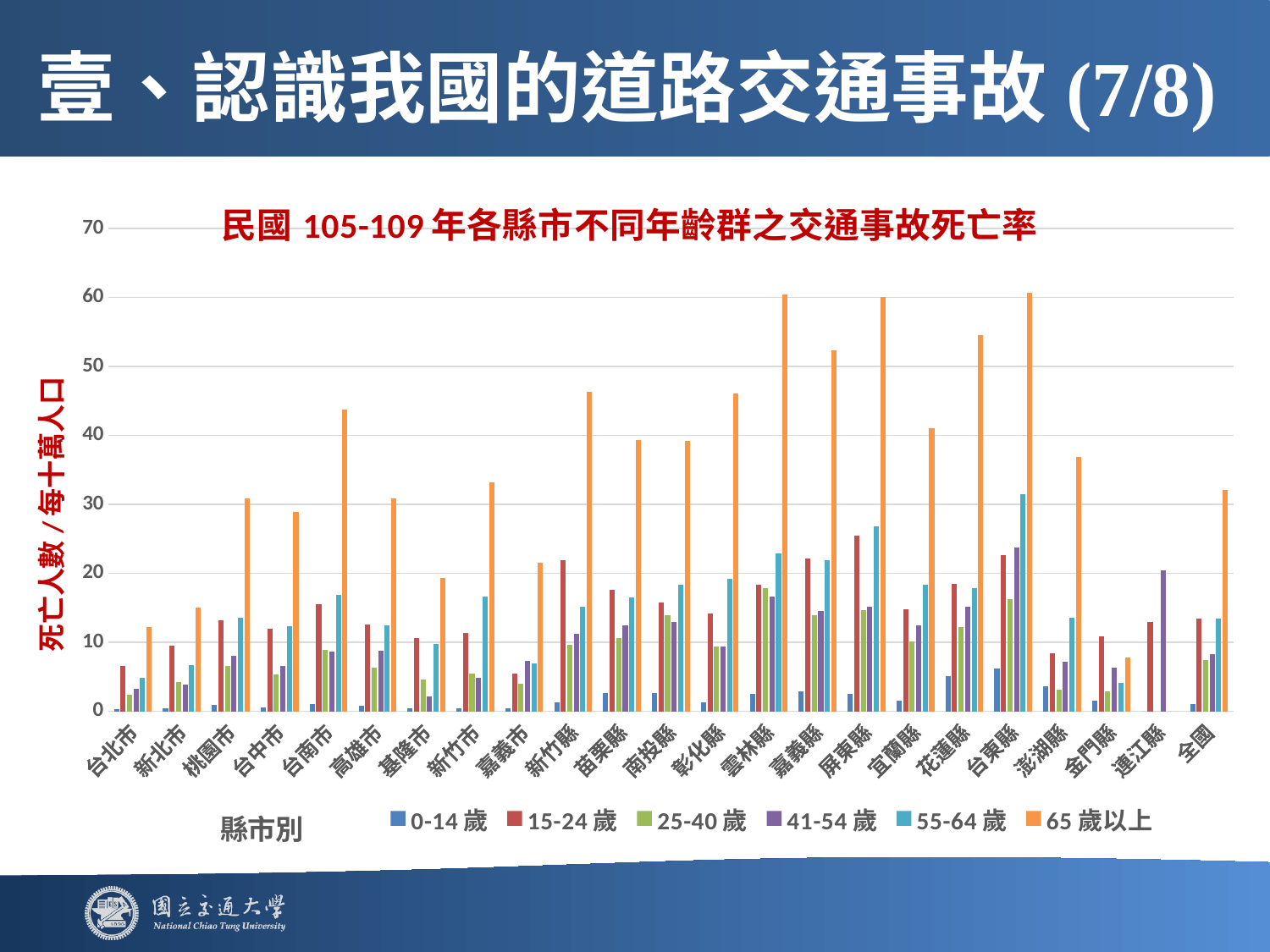
Which age group does the orange series represent? 65 歲以上 Which is larger for the 65 歲以上 series: 雲林縣 or 台北市? 雲林縣 What is the title of the chart? 民國 105-109 年各縣市不同年齡群之交通事故死亡率 Which category has the lowest value for the 65 歲以上 series? 連江縣 What kind of chart is shown on the slide? bar chart How many categories are shown along the x axis? 23 Which category has the highest value for the 15-24 歲 series? 屏東縣 Is the value for 新北市 in the 65 歲以上 series greater or less than 20? less Is the value for 雲林縣 in the 65 歲以上 series greater or less than 50? greater Is the value for 屏東縣 in the 15-24 歲 series greater or less than 20? greater How many series does the legend list? 6 Which category has the highest value for the 55-64 歲 series? 台東縣